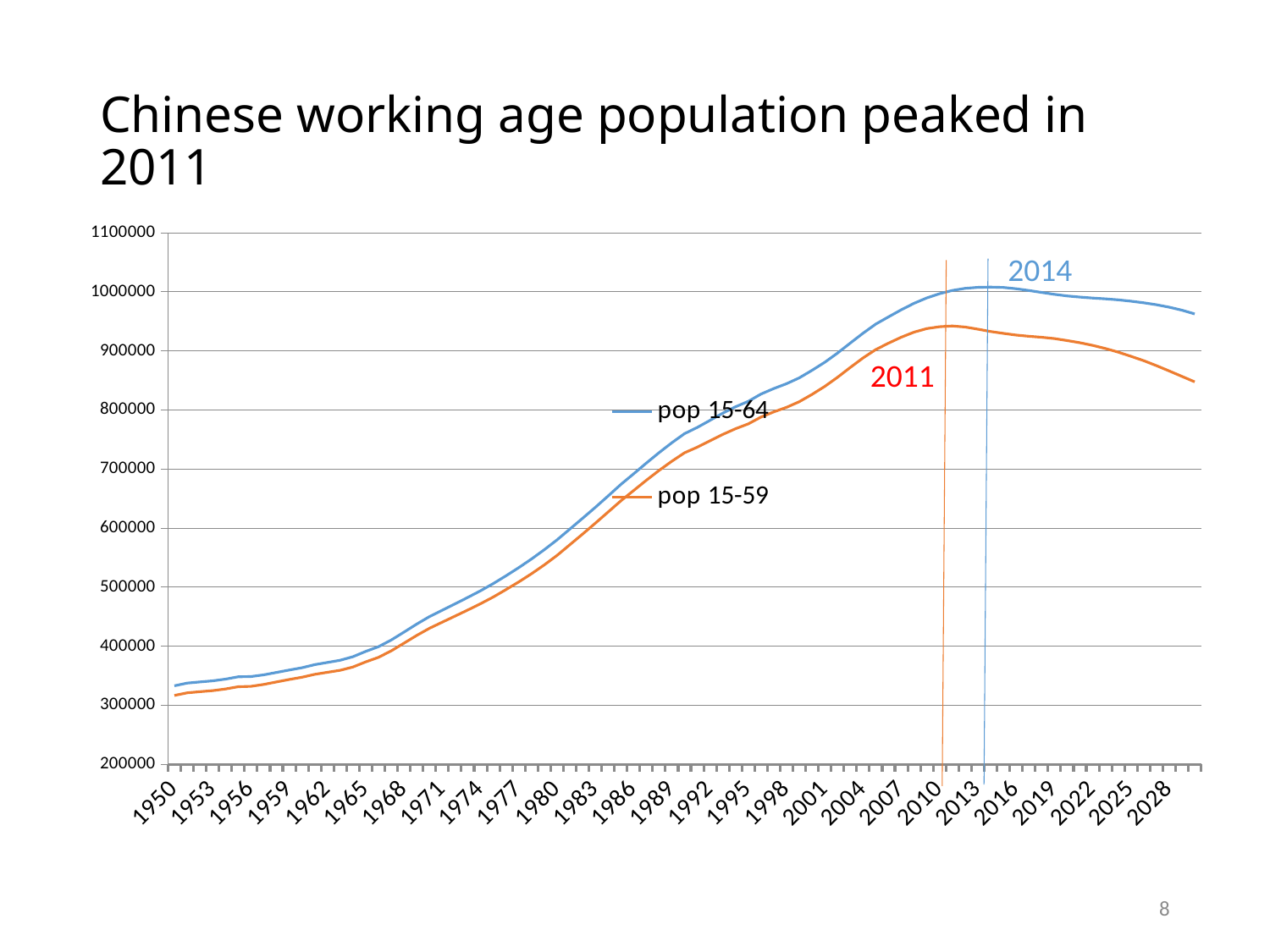
Do the values for pop 15-59 rise or fall between 2016 and 2028? fall Which series is plotted in orange? pop 15-59 What kind of chart is shown on the slide? line chart How many series does the legend list? 2 In which year does the chart annotation mark the peak of the pop 15-59 series? 2011 Is the value for pop 15-64 in 2028 greater or less than 1000000? less Is the value for pop 15-59 in 2028 greater or less than 800000? greater Do the values for pop 15-64 rise or fall between 1950 and 2010? rise In which year does the chart annotation mark the peak of the pop 15-64 series? 2014 What are the two series named in the legend? pop 15-64 and pop 15-59 In 2001, which series has the larger value, pop 15-64 or pop 15-59? pop 15-64 Is the value for pop 15-64 in 1950 greater or less than 400000? less